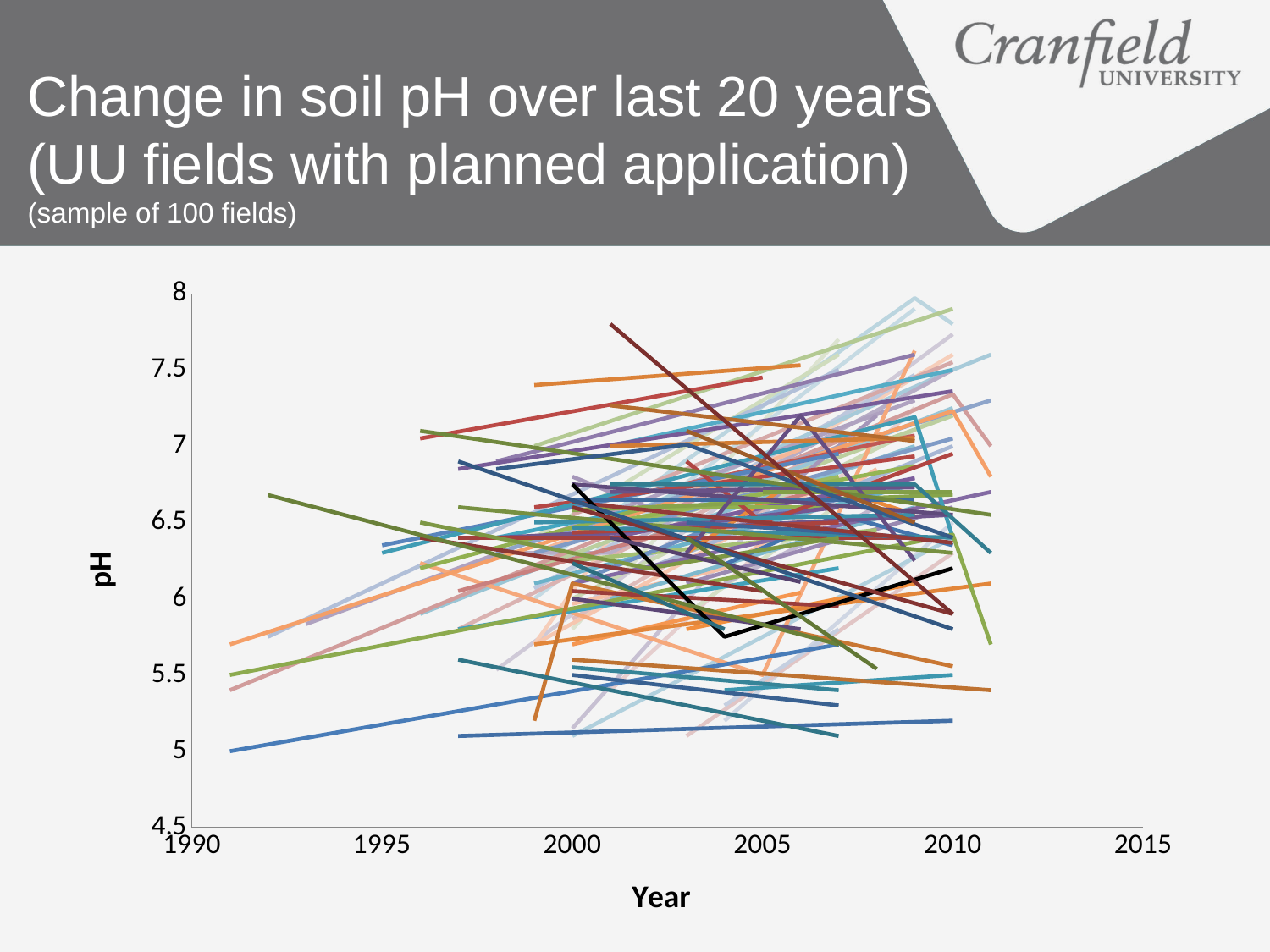
What is the label of the y axis of the chart? pH What is the last year shown on the x axis? 2015 What is the label of the x axis of the chart? Year Is the lowest point of the black line greater or less than 6? less What is the lowest value shown on the pH axis? 4.5 Does the black line rise or fall between 2000 and 2004? fall How many fields are in the sample plotted on the chart? 100 What is the highest value shown on the pH axis? 8 Is the value of the black line in 2000 greater or less than 6.5? greater What kind of chart is shown on the slide? line chart